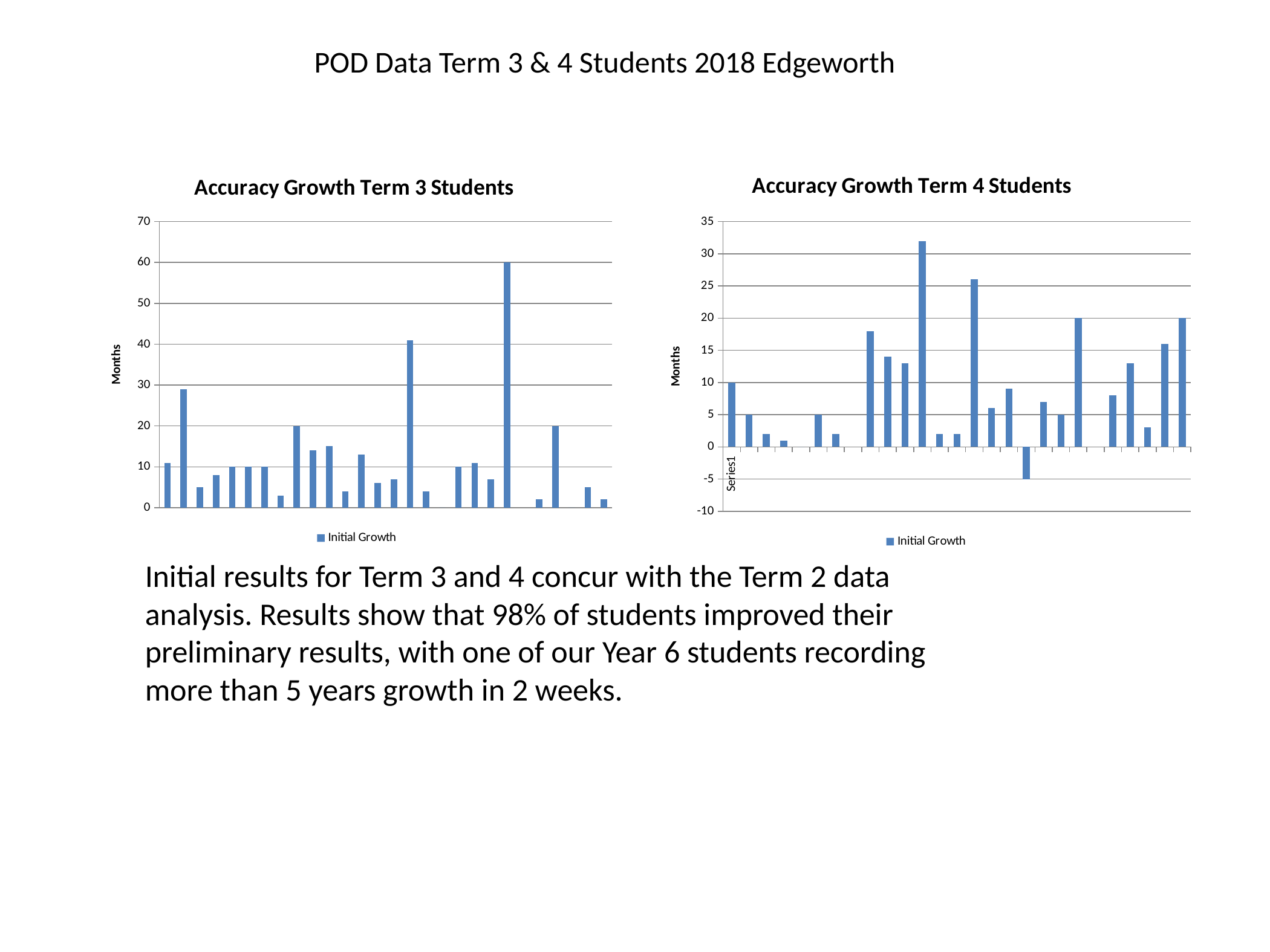
What kind of chart is the "Accuracy Growth Term 4 Students" chart? bar chart In the "Accuracy Growth Term 3 Students" chart, is the value of the second bar from the left greater or less than 20? greater In the "Accuracy Growth Term 3 Students" chart, what is the label on the vertical axis? Months In the "Accuracy Growth Term 3 Students" chart, is the value of the tallest bar greater or less than 50? greater In the "Accuracy Growth Term 4 Students" chart, how many bars extend below zero? 1 Which chart has the higher maximum bar value, "Accuracy Growth Term 3 Students" or "Accuracy Growth Term 4 Students"? Accuracy Growth Term 3 Students What kind of chart is the "Accuracy Growth Term 3 Students" chart? bar chart In the "Accuracy Growth Term 3 Students" chart, how many series does the legend list? 1 In the "Accuracy Growth Term 4 Students" chart, is the value of the first bar on the left greater or less than 5? greater In the "Accuracy Growth Term 4 Students" chart, what is the name of the series shown in the legend? Initial Growth